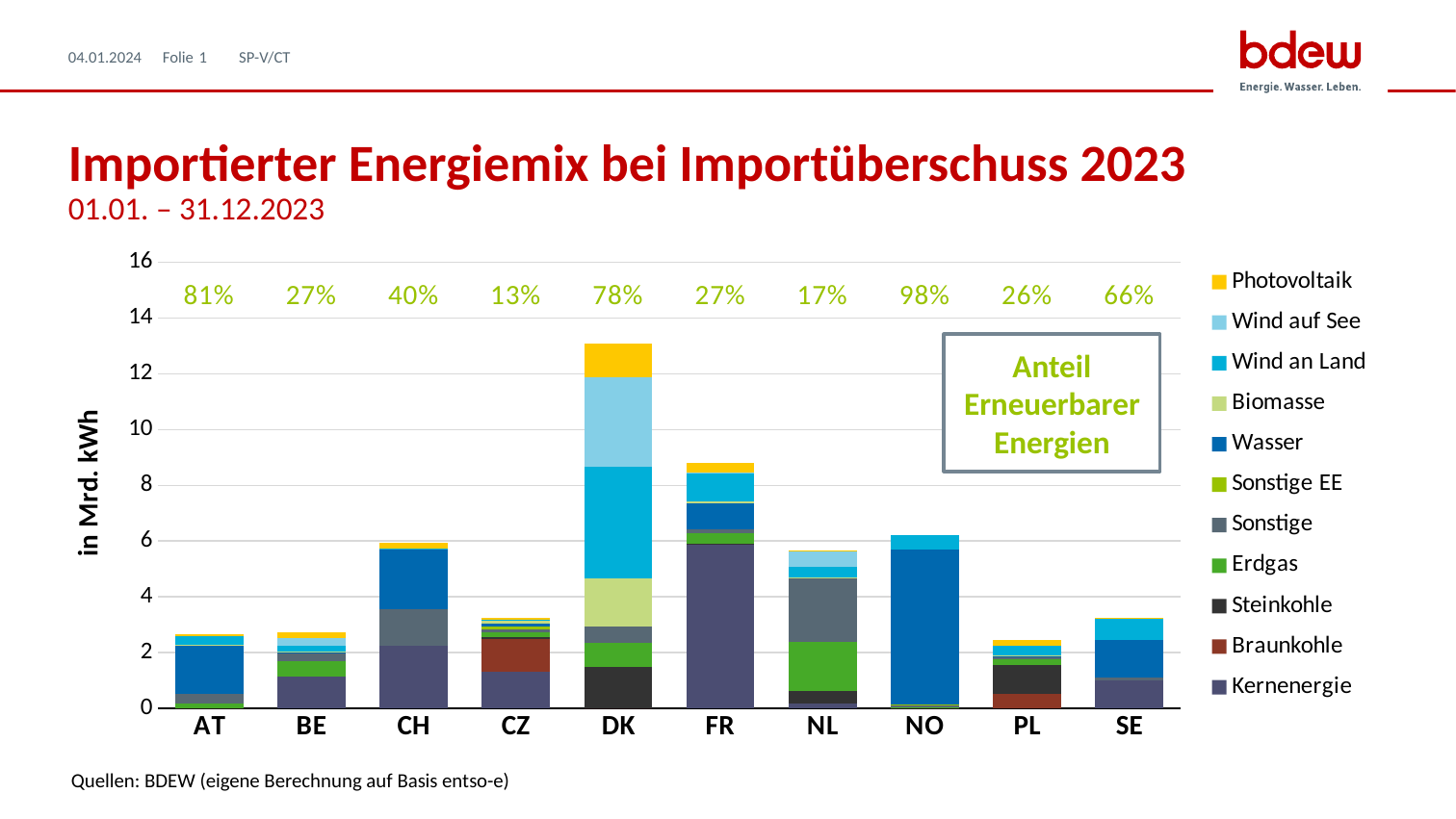
Is the total of the stacked bar for DK greater or less than 12? greater Which country has the lowest printed share of renewable energies? CZ How many countries are shown on the x axis of the chart? 10 Which country has the highest printed share of renewable energies? NO Is the total of the stacked bar for CZ greater or less than 4? less How many series does the legend of the chart list? 11 What is the label of the y axis of the chart? in Mrd. kWh What share of renewable energies is printed above the bar for CZ? 13% What share of renewable energies (Anteil Erneuerbarer Energien) is printed above the bar for AT? 81% What is the difference in percentage points between the renewable share of NO and that of CZ? 85 percentage points Which country has the tallest stacked bar (largest total import)? DK What kind of chart is shown on the slide? Stacked bar chart